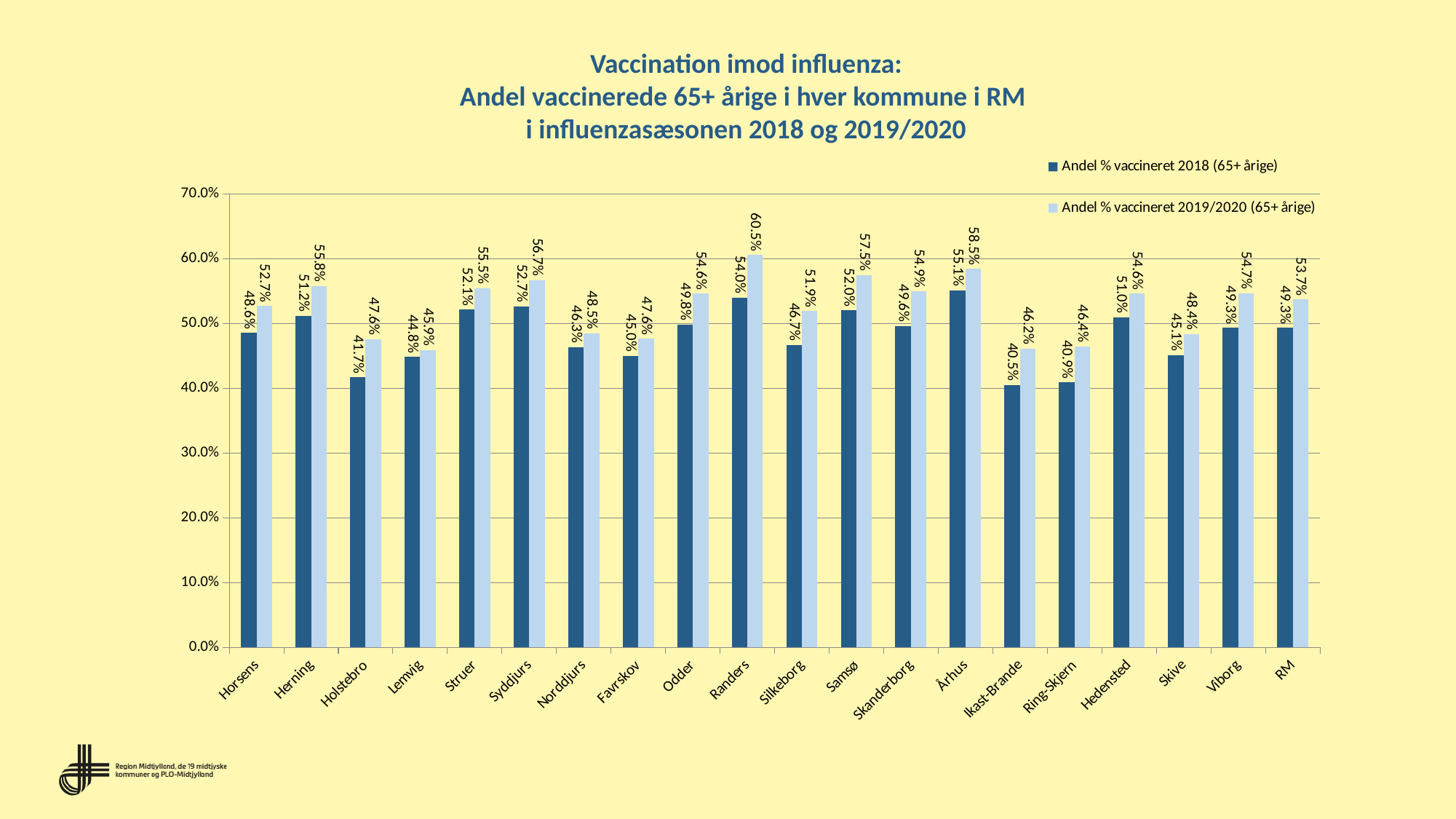
What is the 2019/2020 value for RM? 53.7% Which is larger: the 2019/2020 share for Herning or for Viborg? Herning Which municipality has the highest 2019/2020 vaccination share? Randers Which category has the lowest 2018 vaccination share? Ikast-Brande How many series does the legend list? 2 How many categories are shown on the x axis? 20 What kind of chart is shown on the slide? Bar chart By how many percentage points did Randers' share increase from 2018 to 2019/2020? 6.5 percentage points What was the 2018 vaccination share for Holstebro? 41.7% Which category has the highest 2018 vaccination share? Århus What was the share of vaccinated 65+ year olds in Randers in the 2019/2020 season? 60.5% Is the 2018 value for Ring-Skjern greater or less than 50.0%? less